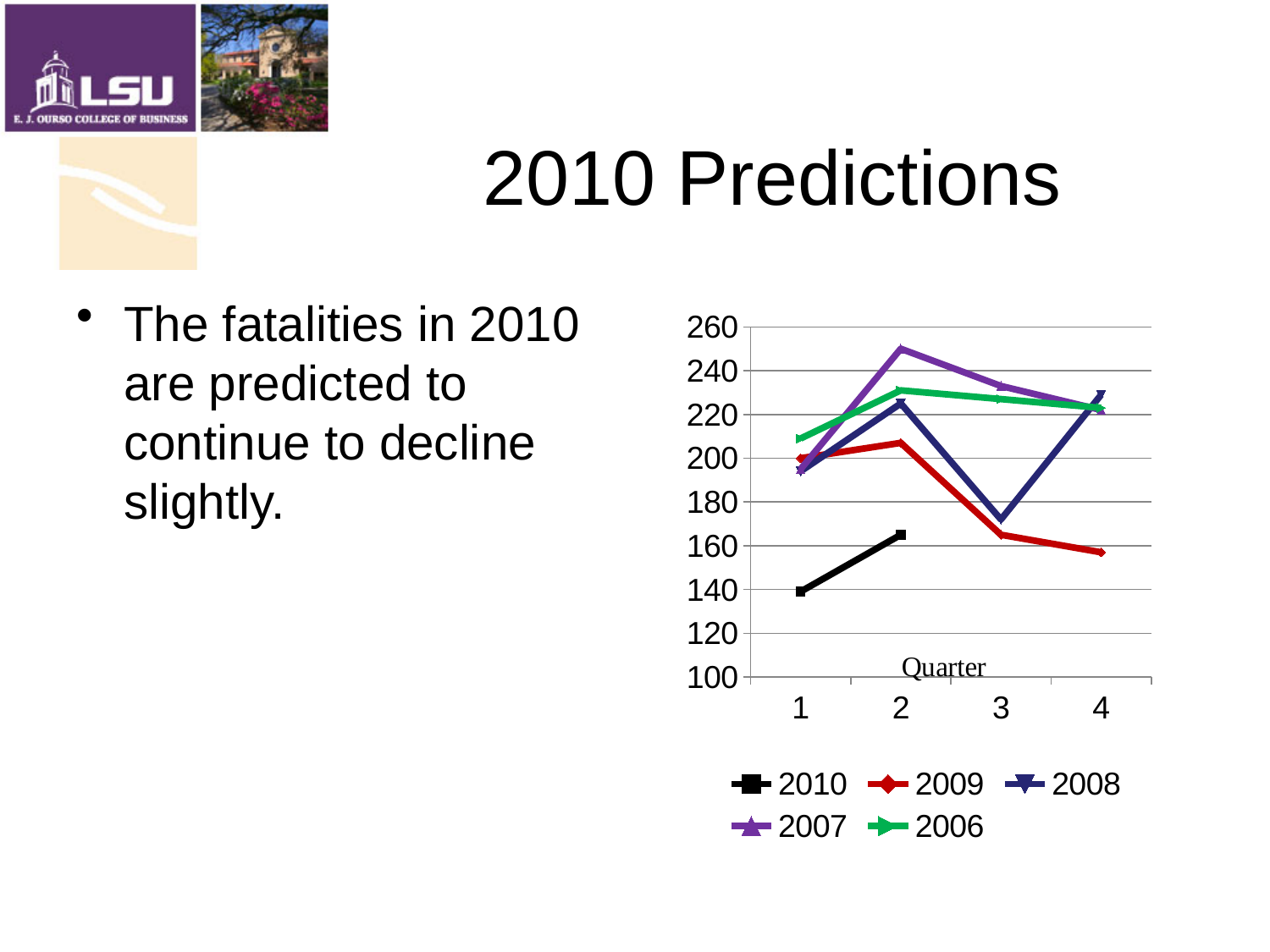
Does the 2009 series rise or fall from quarter 2 to quarter 4? fall Which series has the highest value in quarter 2? 2007 How many series does the chart's legend list? 5 In quarter 3, which is larger: the value for 2007 or the value for 2008? 2007 Which series is drawn in black on the chart? 2010 What is the label shown on the x axis of the chart? Quarter Which series has the lowest value in quarter 1? 2010 How many quarters are shown on the x axis of the chart? 4 What kind of chart is shown on the slide? line chart Is the value for 2007 in quarter 2 greater or less than 240? greater